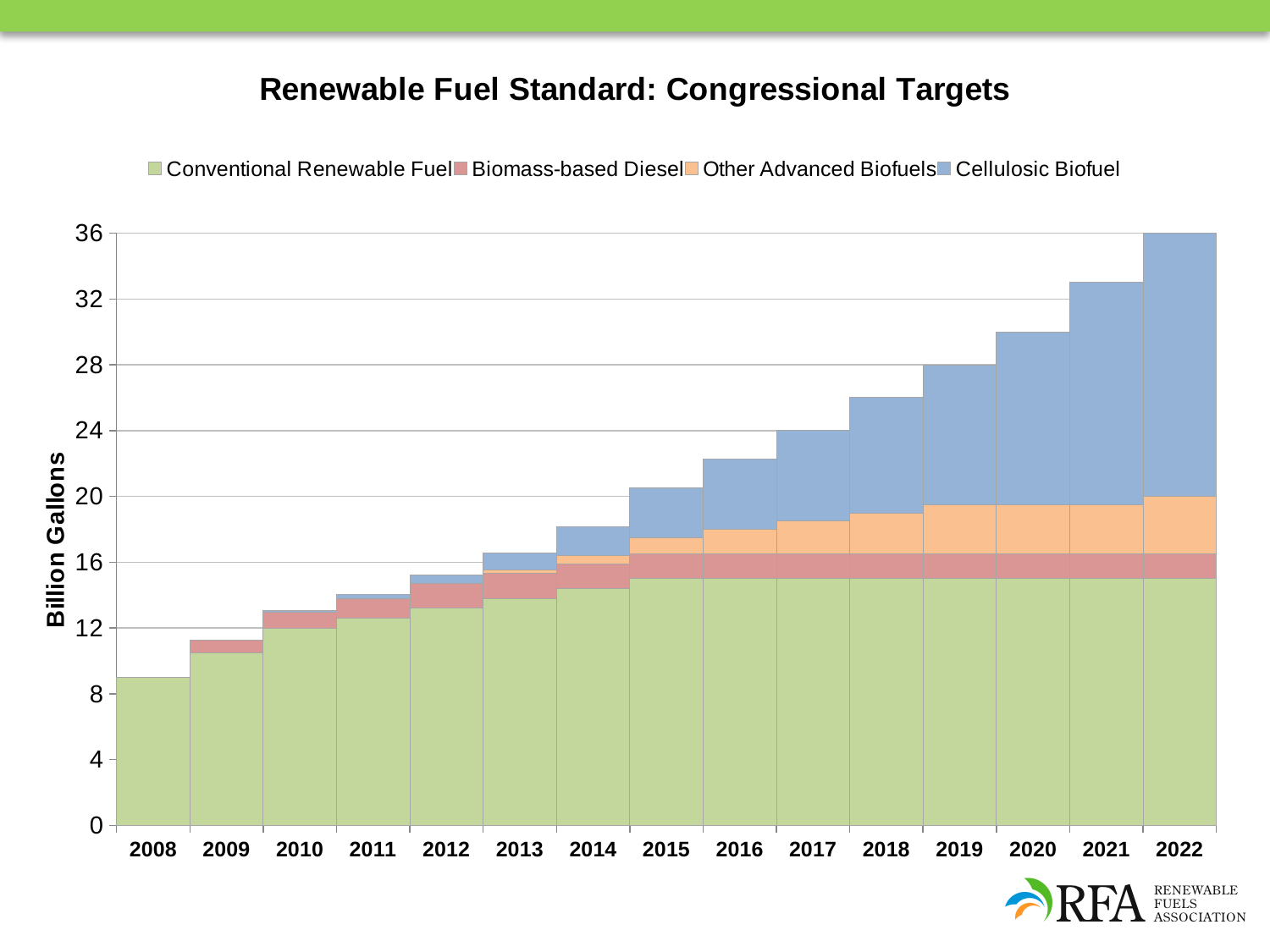
Is the total target for 2012 greater or less than 16 billion gallons? less How many series does the legend list? 4 Which year has a larger total target, 2020 or 2012? 2020 Do the total targets rise or fall from 2008 to 2022? Rise What is the label on the y axis? Billion Gallons What kind of chart is shown on the slide? Stacked bar chart Which year has the highest total target? 2022 What is the total target for 2022 in billion gallons? 36 How many years are shown along the x axis? 15 Is the total target for 2008 greater or less than 12 billion gallons? less Which year has the lowest total target? 2008 Is the total target for 2021 greater or less than 32 billion gallons? greater